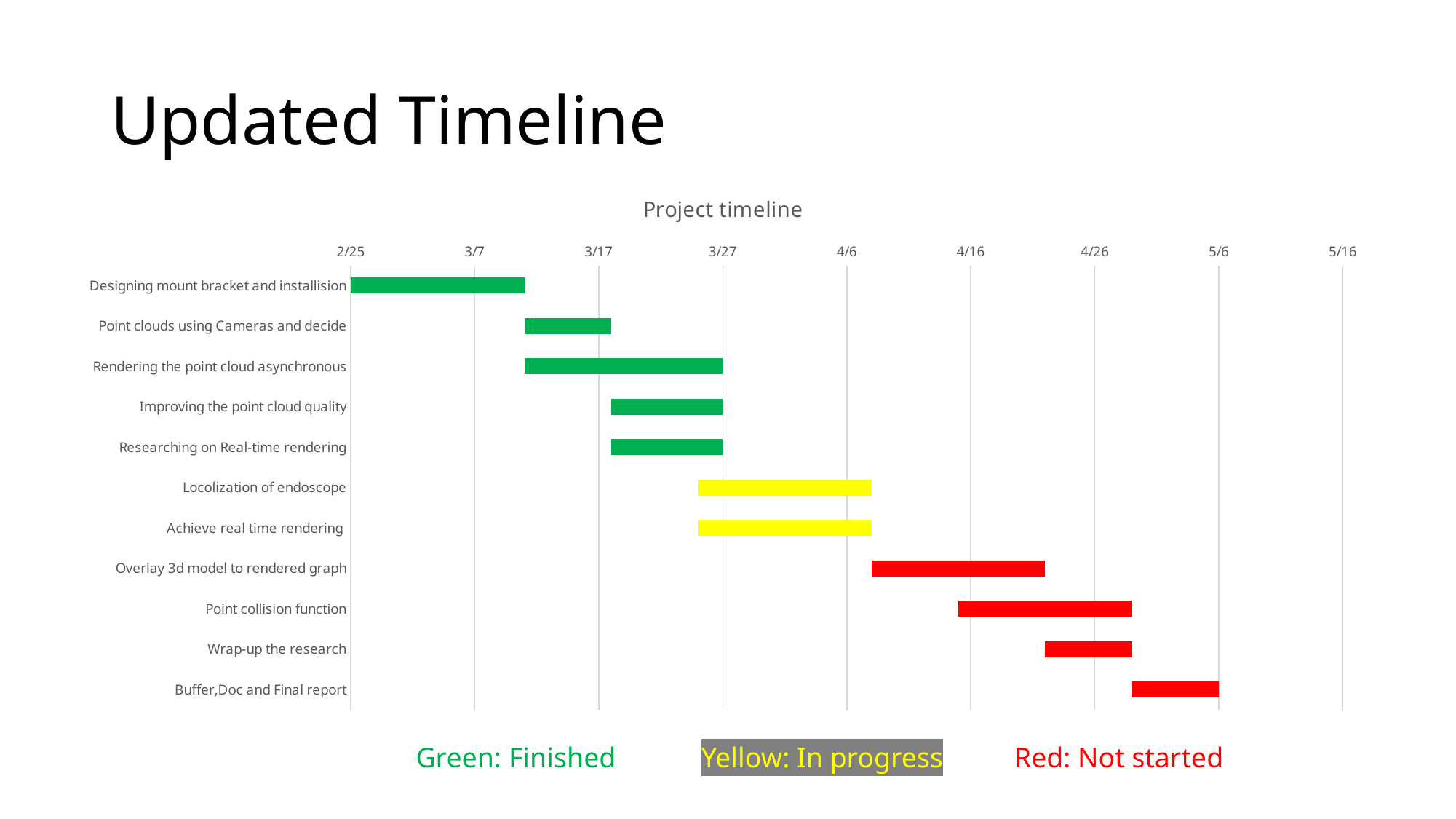
On what date does the bar for 'Buffer,Doc and Final report' end? 5/6 According to the legend below the chart, what does a yellow bar indicate? In progress On what date does the bar for 'Designing mount bracket and installision' start? 2/25 Which task starts earlier, 'Point collision function' or 'Wrap-up the research'? Point collision function Does the bar for 'Locolization of endoscope' start before or after 3/27? before What kind of chart is shown on the slide? Bar chart (Gantt chart) What is the title of the chart? Project timeline On what date does the bar for 'Rendering the point cloud asynchronous' end? 3/27 Does the bar for 'Overlay 3d model to rendered graph' start before or after 4/6? after Which task has the longest bar on the chart? Rendering the point cloud asynchronous Moving down the list of tasks, do the bars start earlier or later? later How many tasks are listed on the chart? 11